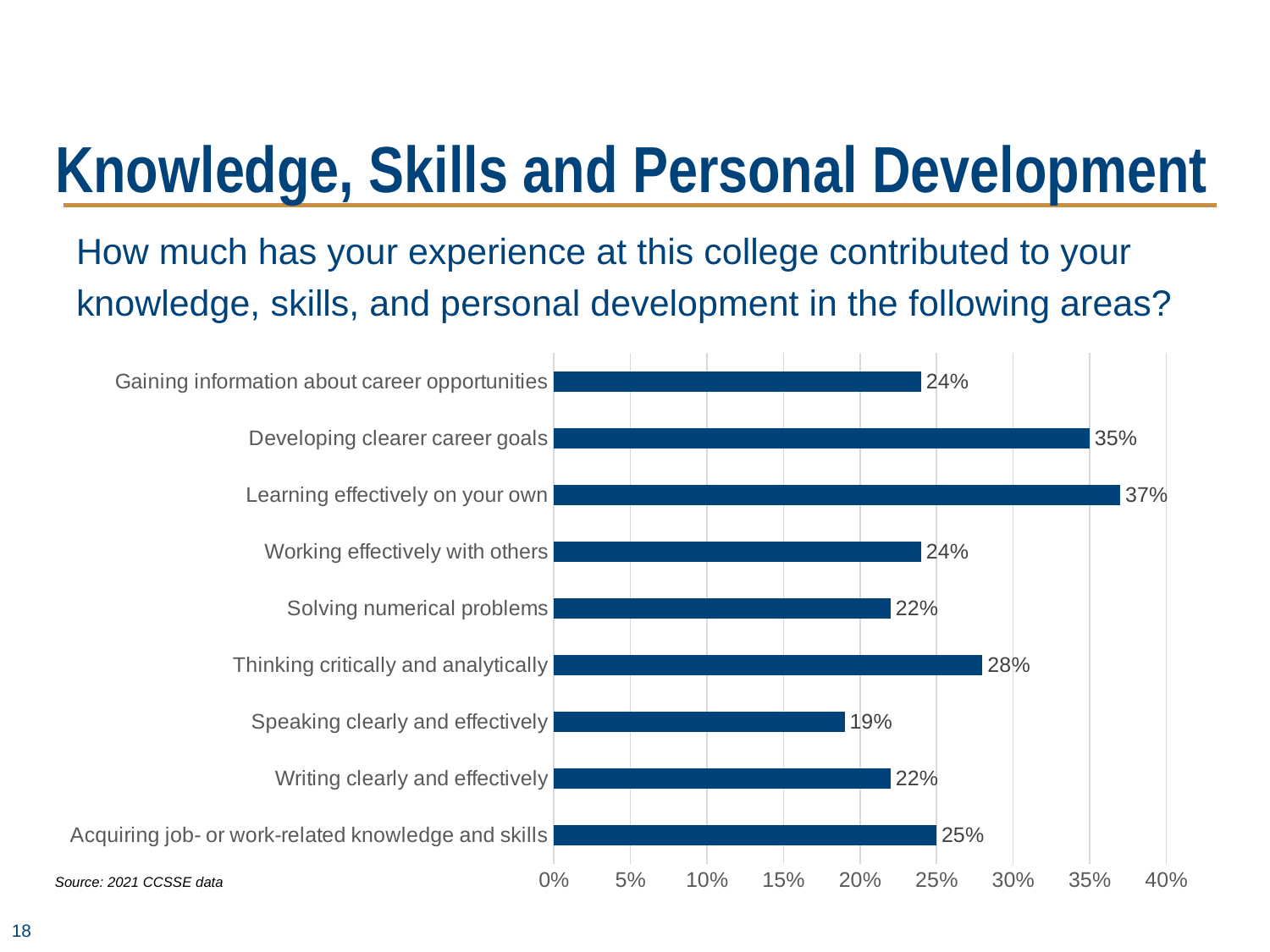
Is the value for Developing clearer career goals greater or less than 30%? greater What is the value for Learning effectively on your own? 37% What is the value for Writing clearly and effectively? 22% What is the difference between Developing clearer career goals and Gaining information about career opportunities? 11% What is the value for Thinking critically and analytically? 28% Which is larger: Acquiring job- or work-related knowledge and skills or Solving numerical problems? Acquiring job- or work-related knowledge and skills What is the source cited for the chart data? 2021 CCSSE data Which category has the lowest value? Speaking clearly and effectively What kind of chart is shown on the slide? bar chart How many categories are shown in the chart? 9 What is the value for Speaking clearly and effectively? 19% Which category has the highest value? Learning effectively on your own